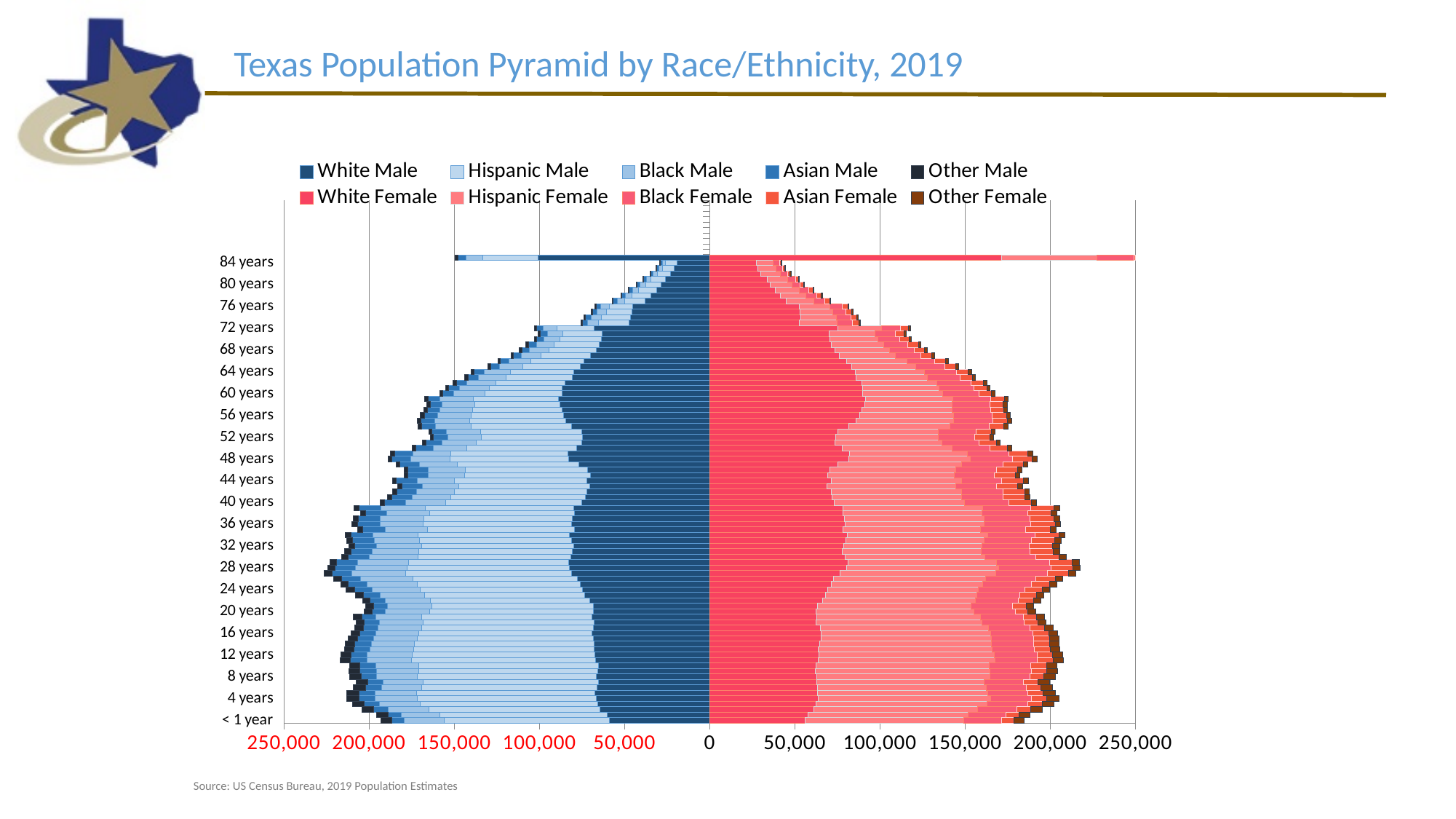
Do the male bars get longer or shorter as age increases from 60 years to 80 years? Shorter Which is larger for males, the total bar at 28 years or the total bar at 80 years? 28 years Is the total female population at 80 years greater or less than 100,000? less What kind of chart is shown on the slide? Bar chart How many series does the legend list? 10 Which is larger at 84 years, the total male bar or the total female bar? Female What is the title of the chart? Texas Population Pyramid by Race/Ethnicity, 2019 Is the total male population at 80 years greater or less than 100,000? less What is the highest value shown on the horizontal axis? 250,000 What source is cited below the chart? US Census Bureau, 2019 Population Estimates Is the total male population at 28 years greater or less than 200,000? greater